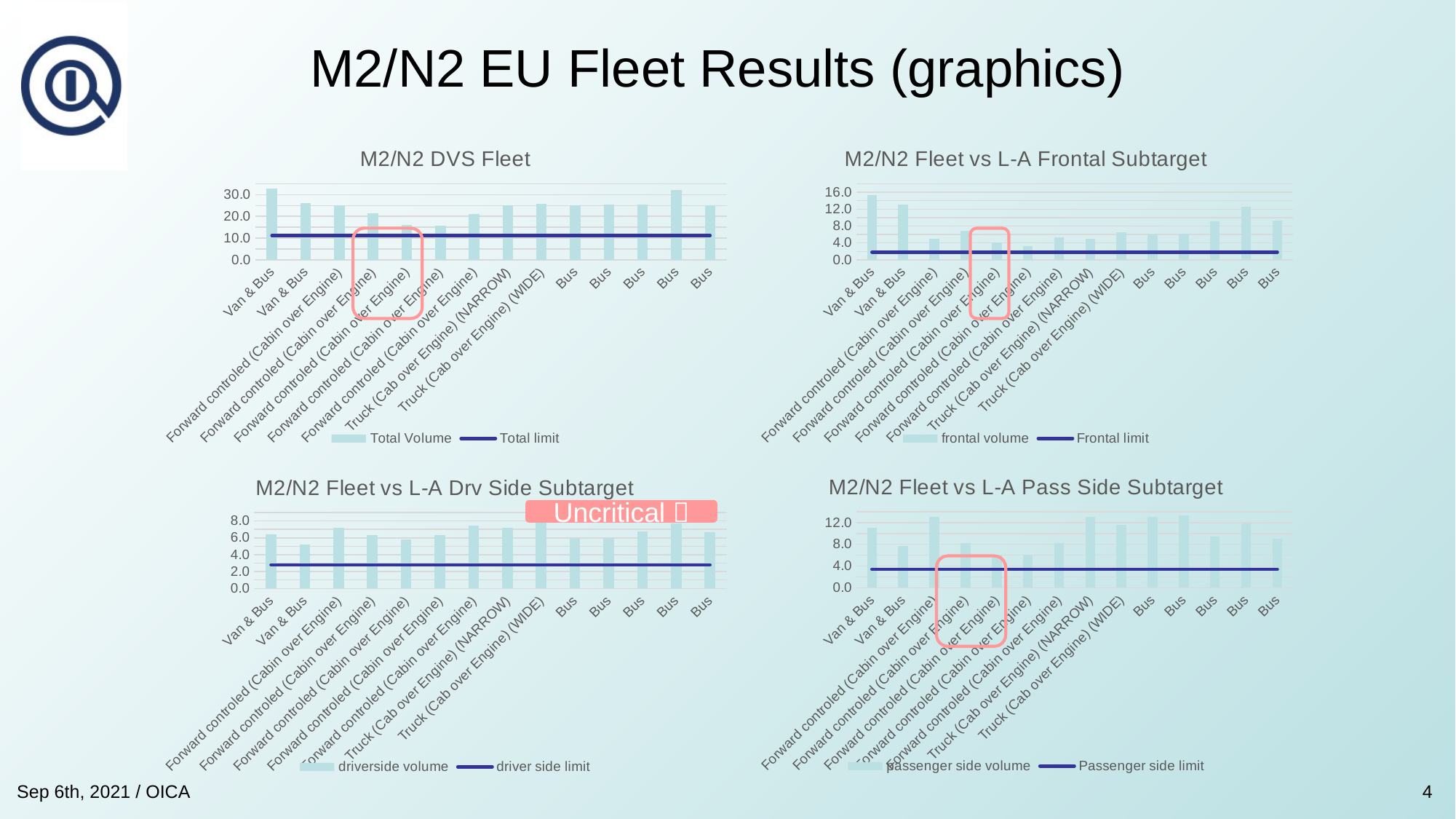
In the 'M2/N2 Fleet vs L-A Frontal Subtarget' chart, which category has the highest frontal volume? Van & Bus (first bar) In the 'M2/N2 Fleet vs L-A Drv Side Subtarget' chart, is the value for the first 'Van & Bus' bar greater or less than 4.0? greater How many series does the legend of the 'M2/N2 Fleet vs L-A Pass Side Subtarget' chart list? 2 What kind of chart is the 'M2/N2 DVS Fleet' chart? bar chart with a line What is the title of the chart in the bottom-right of the slide? M2/N2 Fleet vs L-A Pass Side Subtarget In the 'M2/N2 DVS Fleet' chart, is the value for the first 'Van & Bus' bar greater or less than 30.0? greater How many series does the legend of the 'M2/N2 DVS Fleet' chart list? 2 In the 'M2/N2 Fleet vs L-A Frontal Subtarget' chart, is the value for the first 'Van & Bus' bar greater or less than 12.0? greater How many bars are plotted in the 'M2/N2 Fleet vs L-A Drv Side Subtarget' chart? 14 What are the two legend entries of the 'M2/N2 Fleet vs L-A Frontal Subtarget' chart? frontal volume, Frontal limit In the 'M2/N2 DVS Fleet' chart, which is larger: the first 'Van & Bus' bar or the 'Truck (Cab over Engine) (NARROW)' bar? Van & Bus